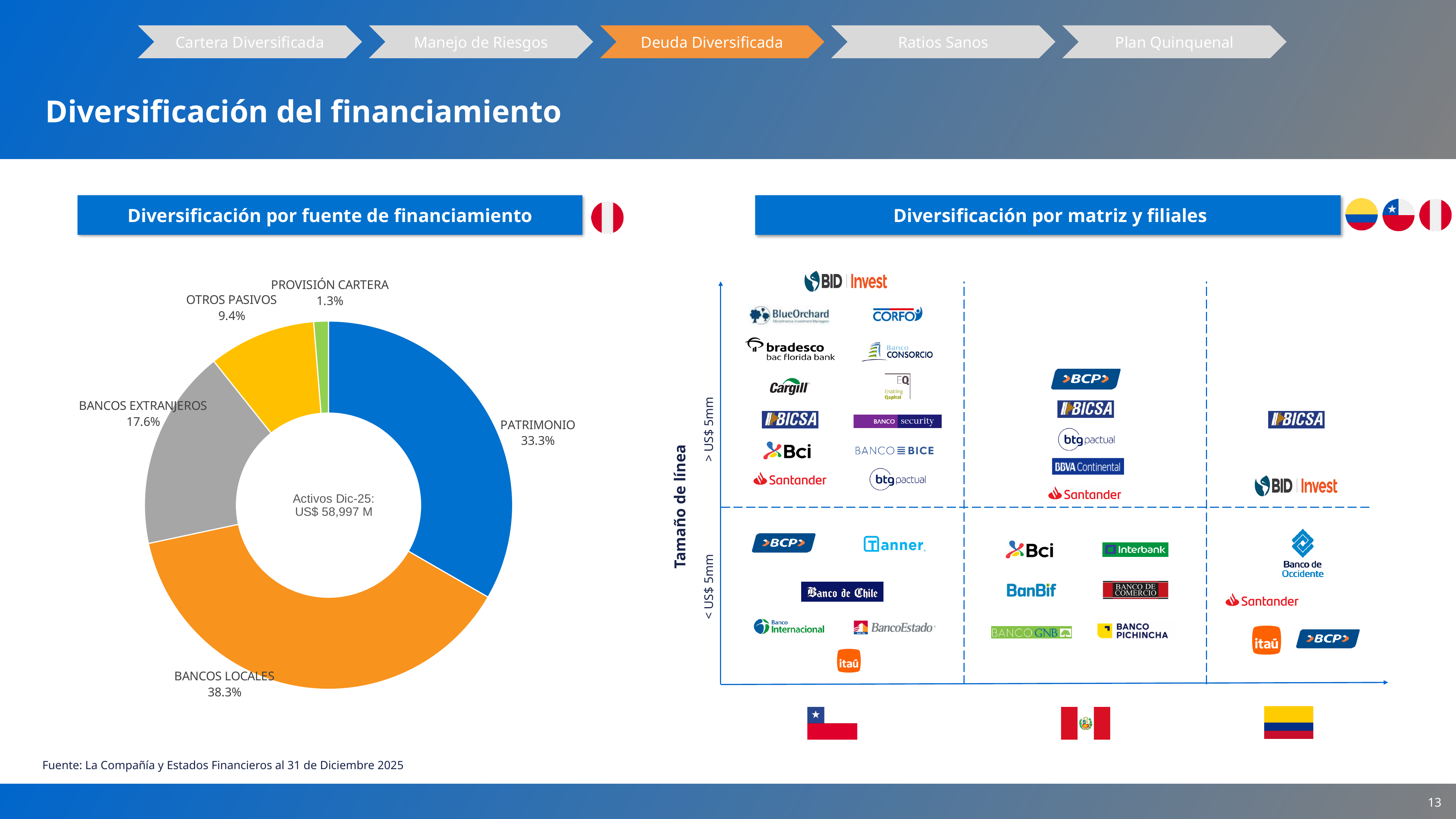
What share of the donut chart does BANCOS LOCALES represent? 38.3% Which category has the smallest share in the donut chart? PROVISIÓN CARTERA Which is larger in the donut chart, BANCOS EXTRANJEROS or OTROS PASIVOS? BANCOS EXTRANJEROS What is the value labelled for BANCOS EXTRANJEROS in the donut chart? 17.6% What is the difference in percentage points between BANCOS LOCALES and PATRIMONIO in the donut chart? 5.0% What type of chart is used to show the diversification by funding source? Donut (pie) chart What percentage does OTROS PASIVOS account for in the donut chart? 9.4% What is the title of the section containing the donut chart? Diversificación por fuente de financiamiento What percentage is shown for PATRIMONIO in the donut chart? 33.3% Which category has the largest share in the donut chart? BANCOS LOCALES What total assets figure is shown in the centre of the donut chart? US$ 58,997 M How many categories are shown in the donut chart? 5